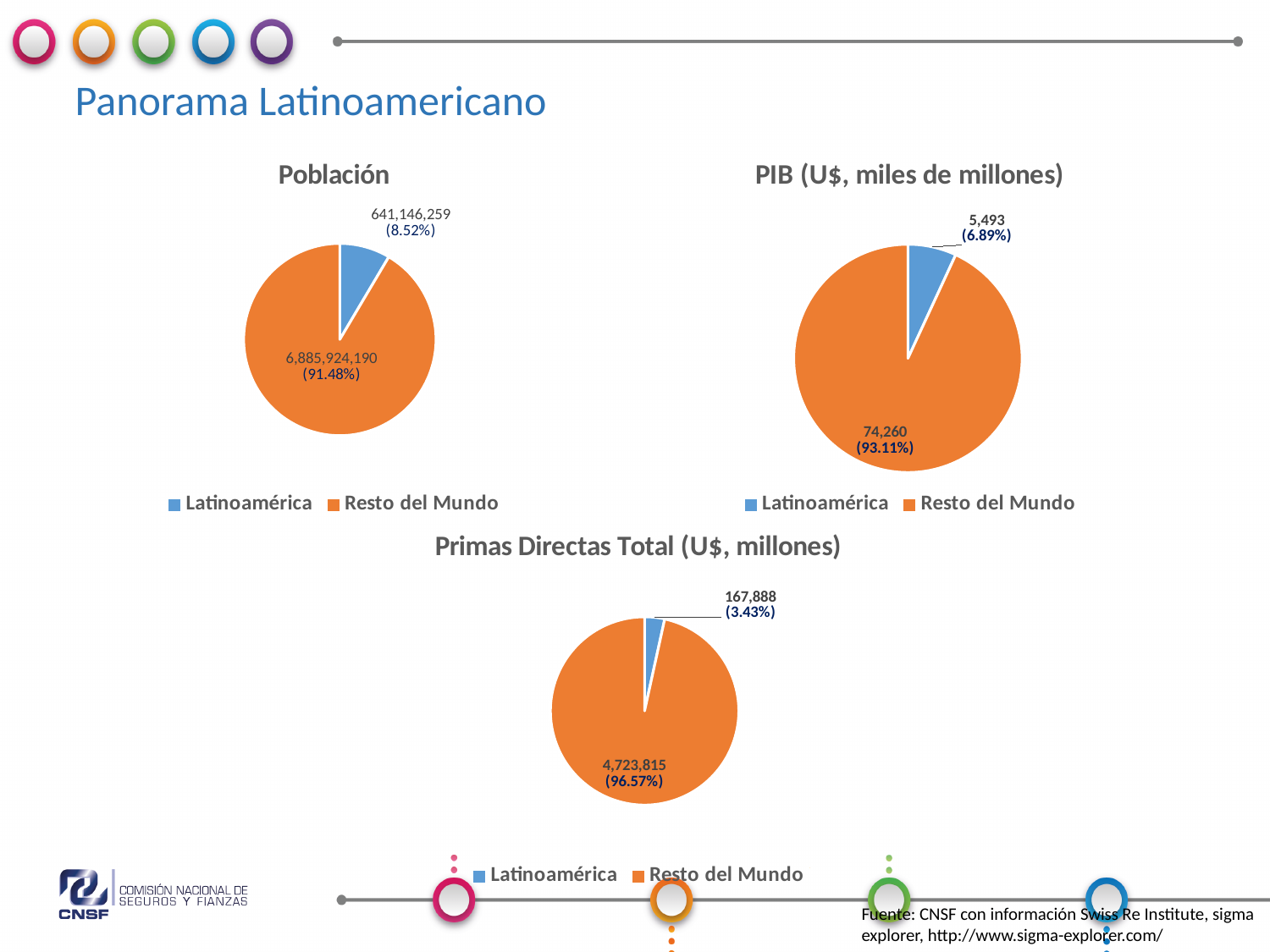
In the 'Población' chart, what share of the pie does Resto del Mundo represent? 91.48% In the 'Primas Directas Total (U$, millones)' chart, what share of the pie does Resto del Mundo represent? 96.57% In the 'PIB (U$, miles de millones)' chart, what is the difference between the Resto del Mundo value and the Latinoamérica value? 68,767 In the 'Primas Directas Total (U$, millones)' chart, which category has the largest slice? Resto del Mundo In the 'Primas Directas Total (U$, millones)' chart, what is the value for Latinoamérica? 167,888 In the 'PIB (U$, miles de millones)' chart, what share of the pie does Latinoamérica represent? 6.89% In the 'PIB (U$, miles de millones)' chart, what is the value for Resto del Mundo? 74,260 What kind of chart is the 'Población' chart? Pie chart In the 'Población' chart, what is the value for Latinoamérica? 641,146,259 In the 'PIB (U$, miles de millones)' chart, which category has the smallest slice? Latinoamérica In the 'Población' chart, which colour represents Latinoamérica? Blue How many categories does the legend of the 'Primas Directas Total (U$, millones)' chart list? 2